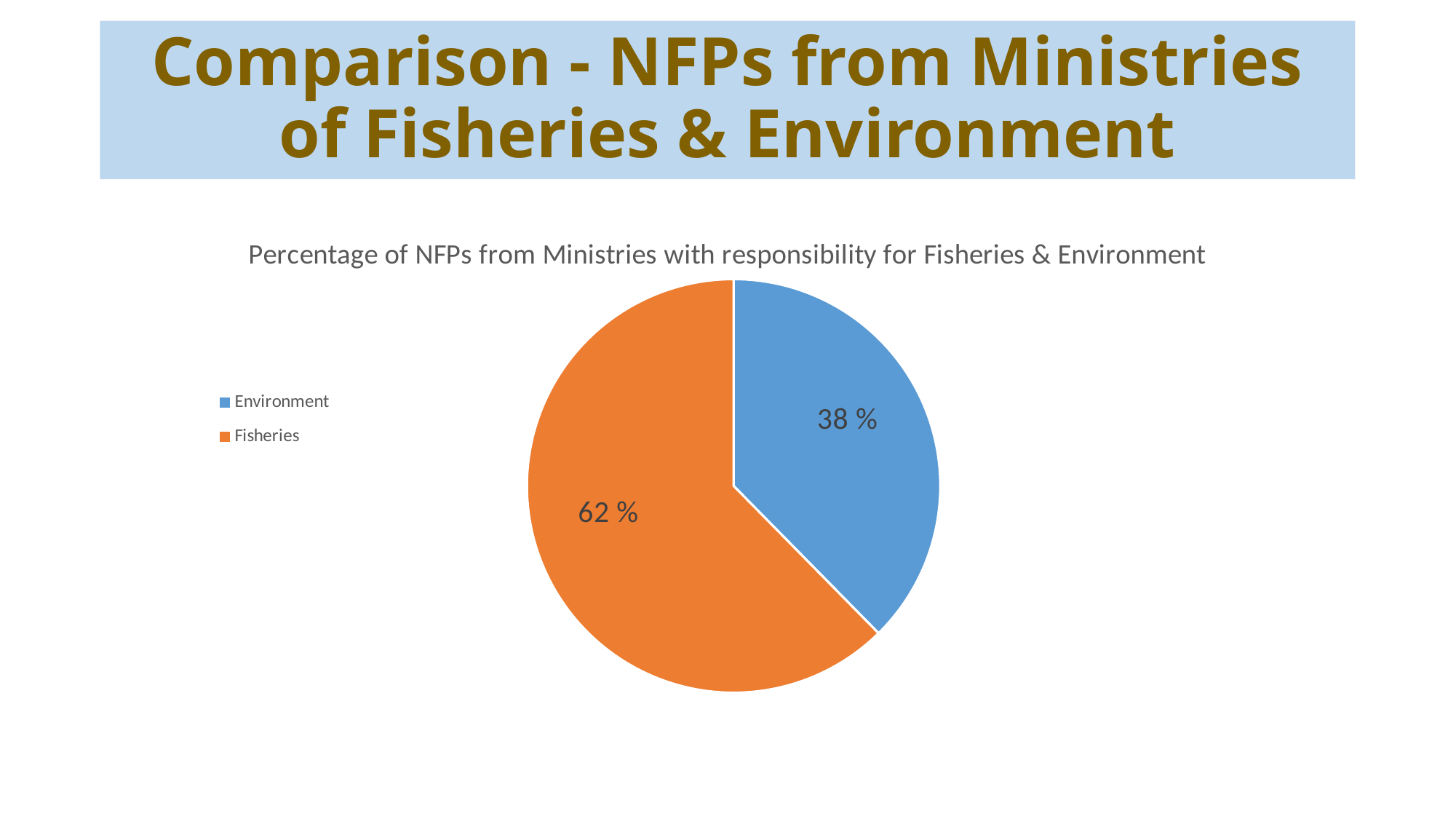
What is the difference in percentage points between the Fisheries and Environment shares? 24 Which category has the larger share of the pie? Fisheries How many entries does the legend list? 2 How many slices does the pie chart have? 2 What kind of chart is shown on the slide? pie chart What percentage of NFPs come from Ministries with responsibility for Environment? 38 % Is the share for Fisheries larger or smaller than the share for Environment? larger What percentage of NFPs come from Ministries with responsibility for Fisheries? 62 % What is the title of the chart? Percentage of NFPs from Ministries with responsibility for Fisheries & Environment Which category has the smaller share of the pie? Environment What colour is the Fisheries slice? orange What share of the pie does the Environment slice represent? 38 %